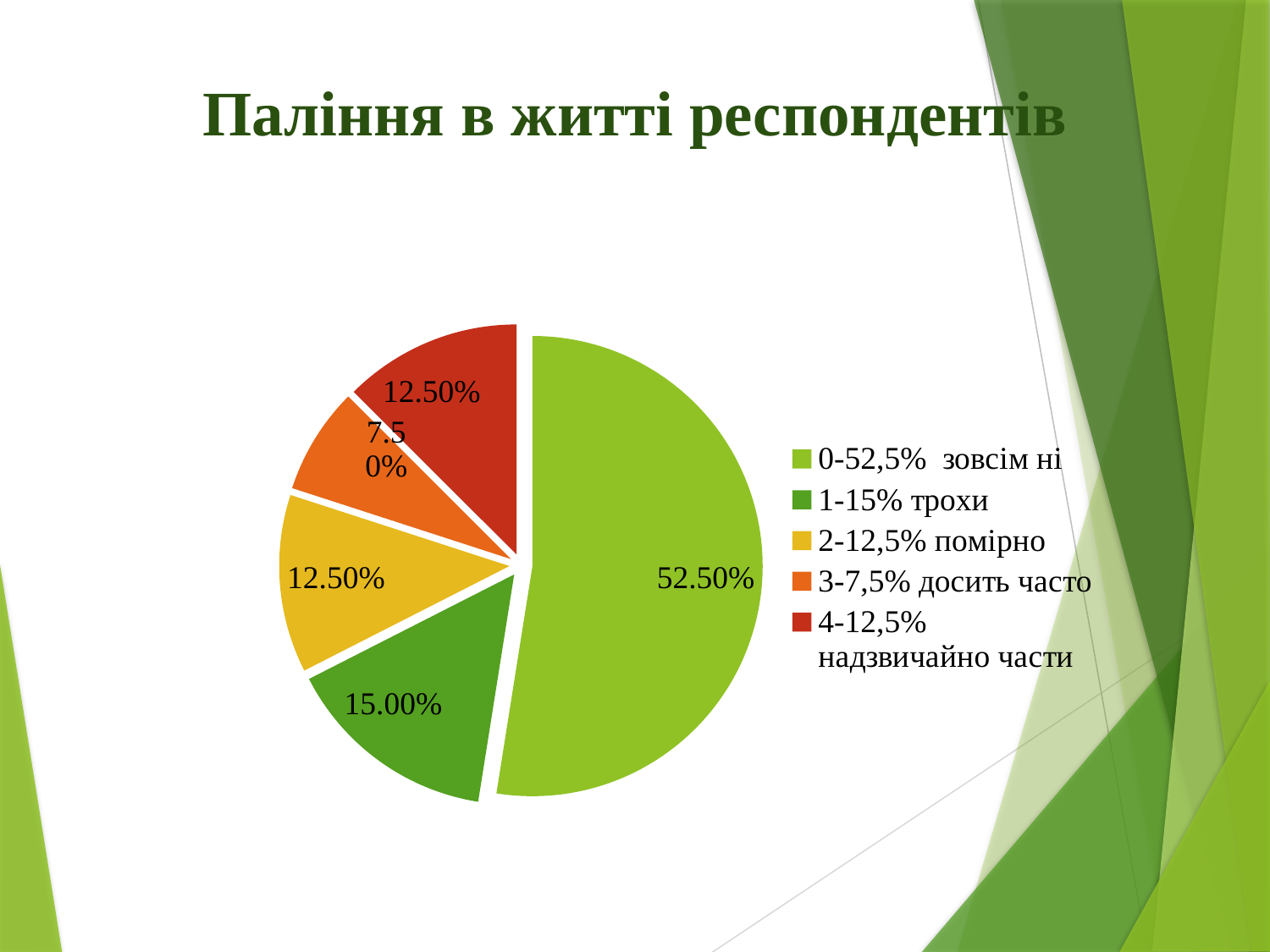
What value is shown for the 'помірно' slice? 12.50% What value is shown for the 'досить часто' slice? 7.50% What is the difference between the 'зовсім ні' slice and the 'трохи' slice? 37.50% Which category has the smallest slice of the pie? досить часто What share of the pie does the 'зовсім ні' slice represent? 52.50% Which is larger, the 'трохи' slice or the 'помірно' slice? трохи Which category has the largest slice of the pie? зовсім ні What kind of chart is shown on the slide? pie chart What value is shown for the 'трохи' slice? 15.00% What is the title of the chart on the slide? Паління в житті респондентів How many entries does the legend list? 5 How many slices does the pie chart have? 5